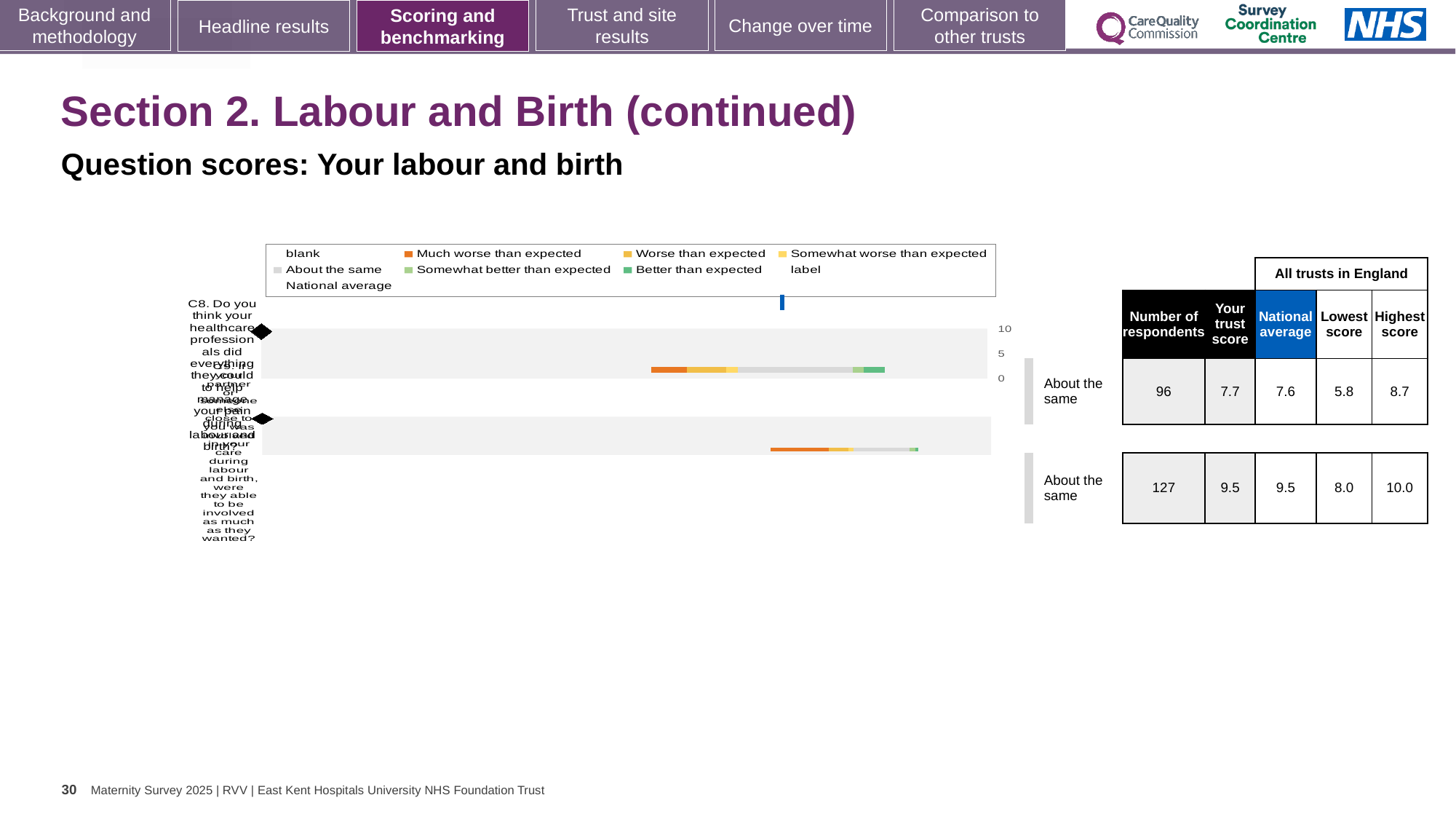
According to the table beside the chart, what is the trust score for question C8 about managing pain during labour and birth? 7.7 How many survey questions (bars) are plotted in the chart? 2 In the chart legend, what colour represents 'Much worse than expected'? orange According to the table beside the chart, what is the national average for question C8 about managing pain during labour and birth? 7.6 What kind of chart is shown on the slide? bar chart According to the table, what is the trust score for the second (lower) question in the chart? 9.5 According to the table beside the chart, how many respondents answered question C8 about managing pain during labour and birth? 96 What is the highest tick value shown on the chart's score axis? 10 In the chart legend, what colour represents 'Better than expected'? green According to the table, what is the highest score across all trusts in England for the second (lower) question in the chart? 10.0 For question C8, what is the difference between the highest score and the lowest score across all trusts in England? 2.9 For question C8, which is larger: the trust score or the national average? trust score